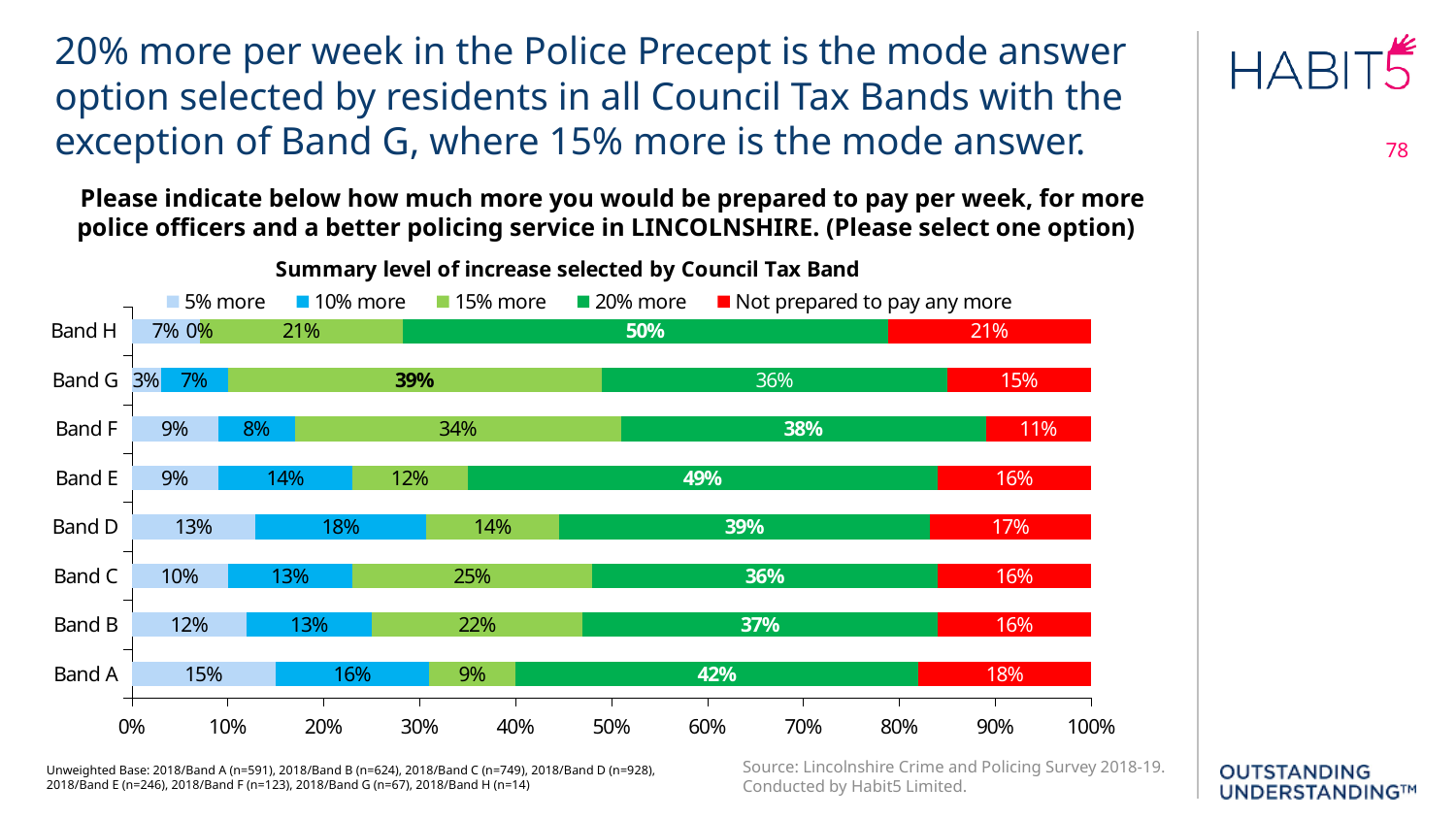
What kind of chart is shown on the slide? Stacked bar chart What is the title of the chart? Summary level of increase selected by Council Tax Band How many series does the legend list? 5 Which is larger: the '15% more' share for Band C or for Band B? Band C Which Council Tax Band has the lowest share selecting '5% more'? Band G What percentage of Band A residents were 'Not prepared to pay any more'? 18% What percentage of Band D residents selected '10% more'? 18% What is the difference between the '20% more' shares for Band E and Band D? 10% What percentage of Band G residents selected '15% more'? 39% Which Council Tax Band has the highest share selecting '20% more'? Band H What percentage of Band H residents selected '20% more'? 50% How many Council Tax Bands are shown in the chart? 8